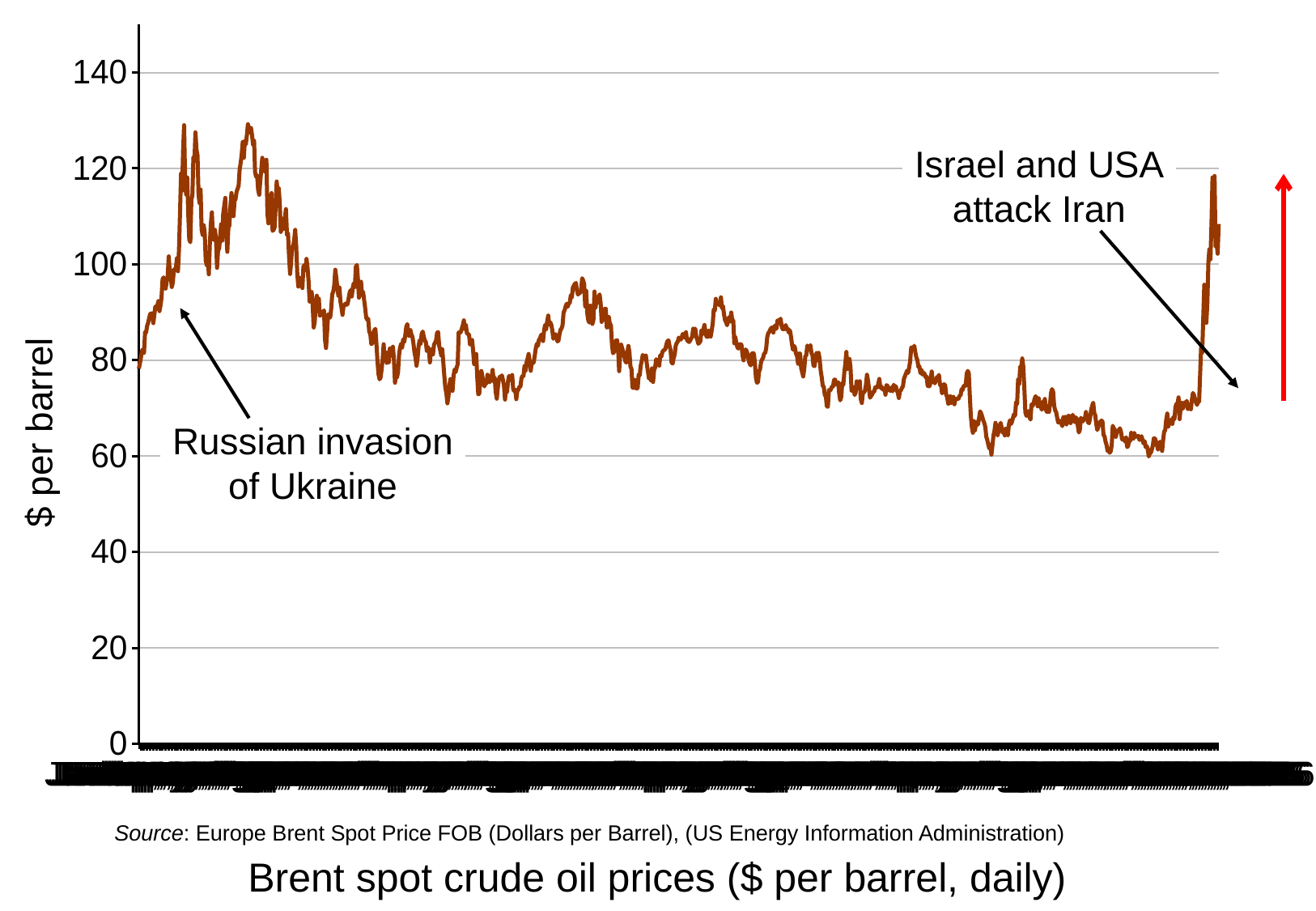
Is the highest value reached on the chart greater or less than 140? less Is the lowest value reached on the chart greater or less than 80? less Is the value at the point marked 'Russian invasion of Ukraine' greater or less than 80? greater What is the title of the chart? Brent spot crude oil prices ($ per barrel, daily) What kind of chart is shown on the slide? line chart What is the label on the vertical axis of the chart? $ per barrel How many data series are plotted on the chart? 1 Between the peak shortly after the 'Russian invasion of Ukraine' annotation and the point marked 'Israel and USA attack Iran', do prices generally rise or fall? fall